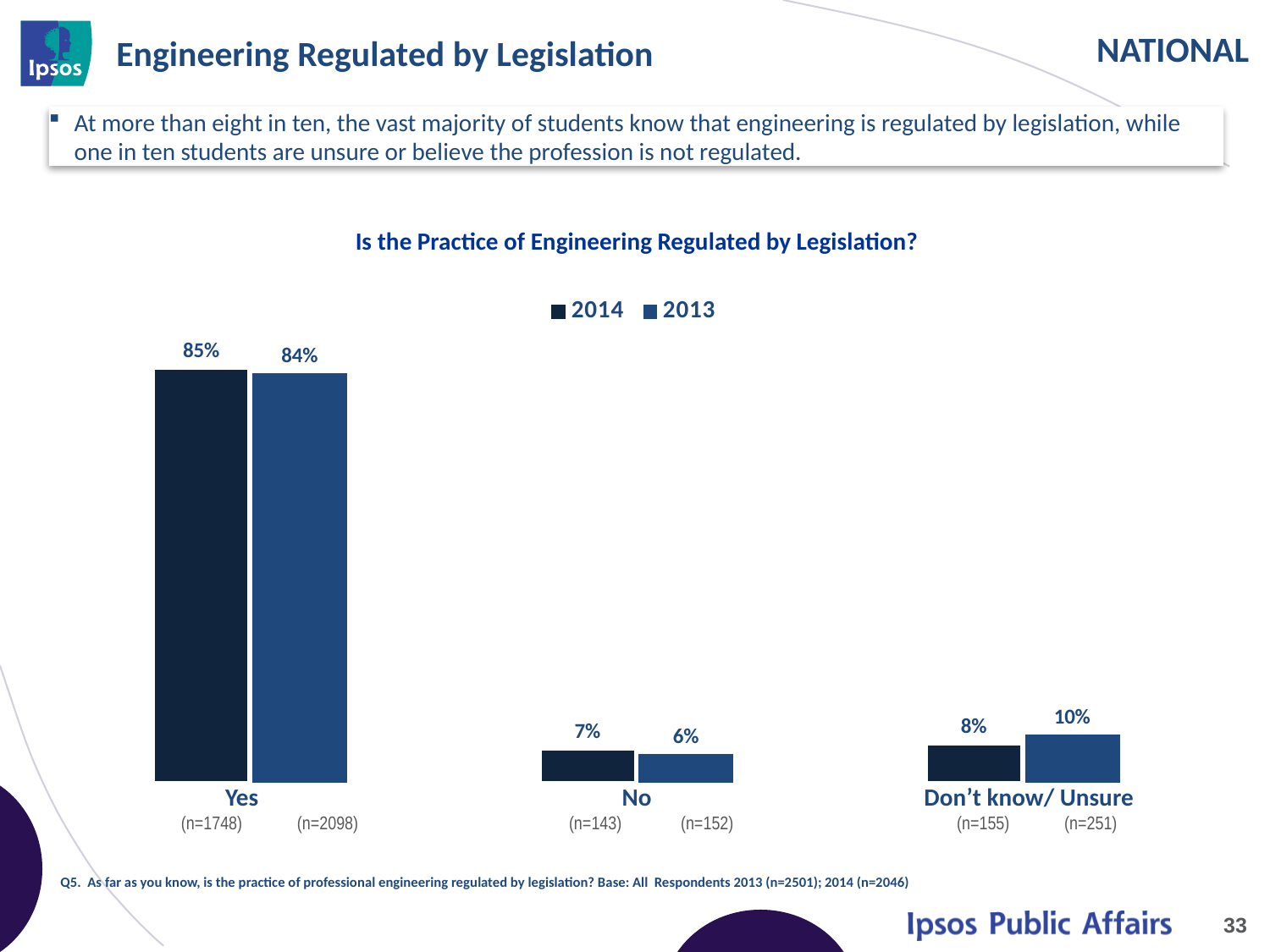
What is the title of the chart? Is the Practice of Engineering Regulated by Legislation? Which category has the lowest value for 2013? No What percentage of students answered Yes in 2013? 84% What is the 2013 value for Don't know/ Unsure? 10% What kind of chart is shown on the slide? Bar chart Which category has the highest value for 2014? Yes How many series does the legend list? 2 How many categories are shown on the x axis? 3 What is the 2014 value for No? 7% What percentage of students answered Yes in 2014? 85% What is the difference between the 2013 and 2014 values for Don't know/ Unsure? 2% Which is larger for the No category, the 2014 value or the 2013 value? 2014